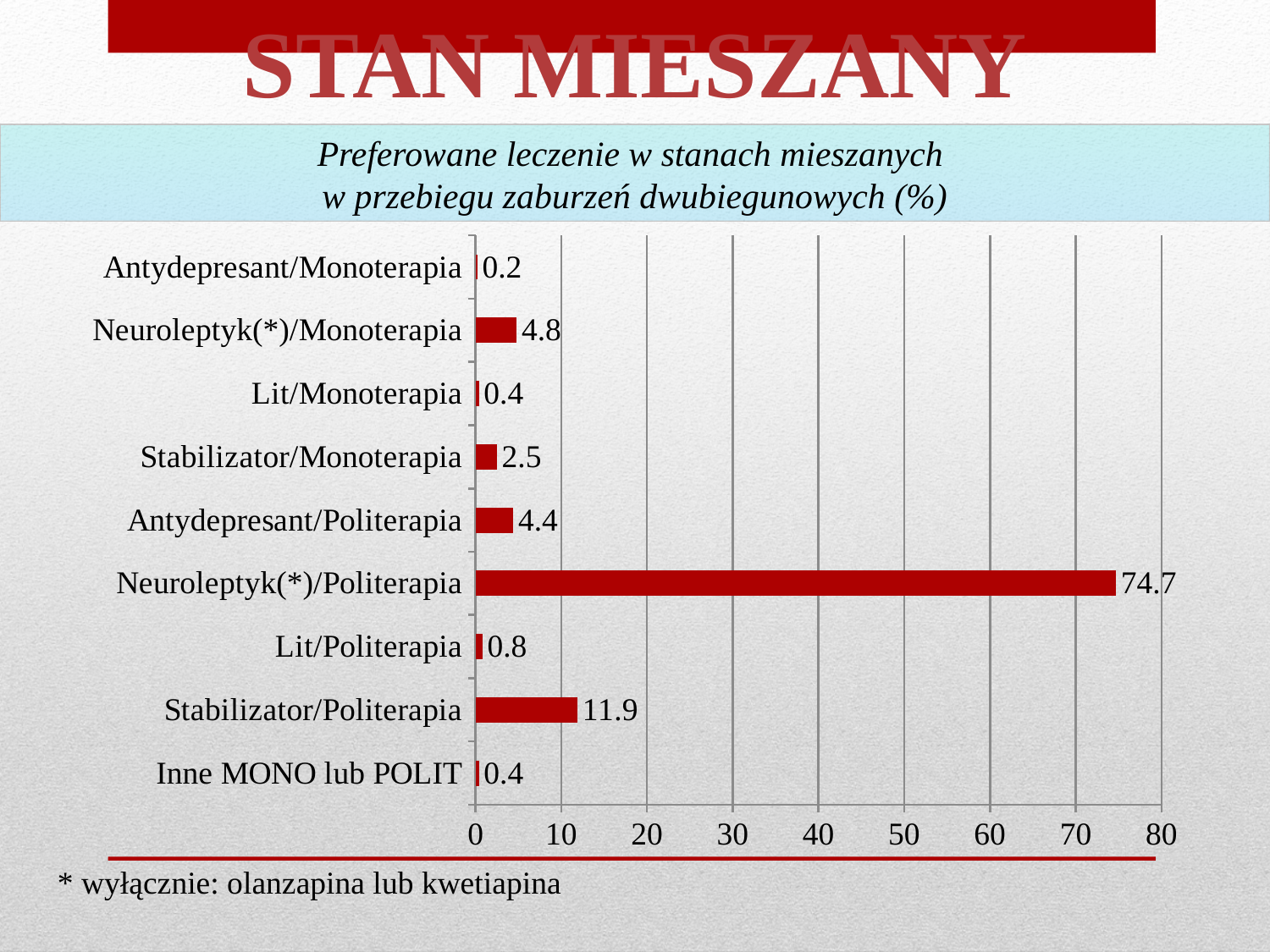
Is the value for Neuroleptyk(*)/Politerapia greater or less than 70? greater What colour are the bars in the chart? dark red What is the value for Lit/Politerapia? 0.8 Which is larger, the value for Stabilizator/Politerapia or the value for Stabilizator/Monoterapia? Stabilizator/Politerapia How many categories are shown in the chart? 9 What is the difference between the values for Neuroleptyk(*)/Politerapia and Stabilizator/Politerapia? 62.8 What kind of chart is shown on the slide? bar chart What is the value for Stabilizator/Politerapia? 11.9 Which category has the lowest value? Antydepresant/Monoterapia Which category has the highest value? Neuroleptyk(*)/Politerapia What is the value for Stabilizator/Monoterapia? 2.5 What is the value for Neuroleptyk(*)/Politerapia? 74.7